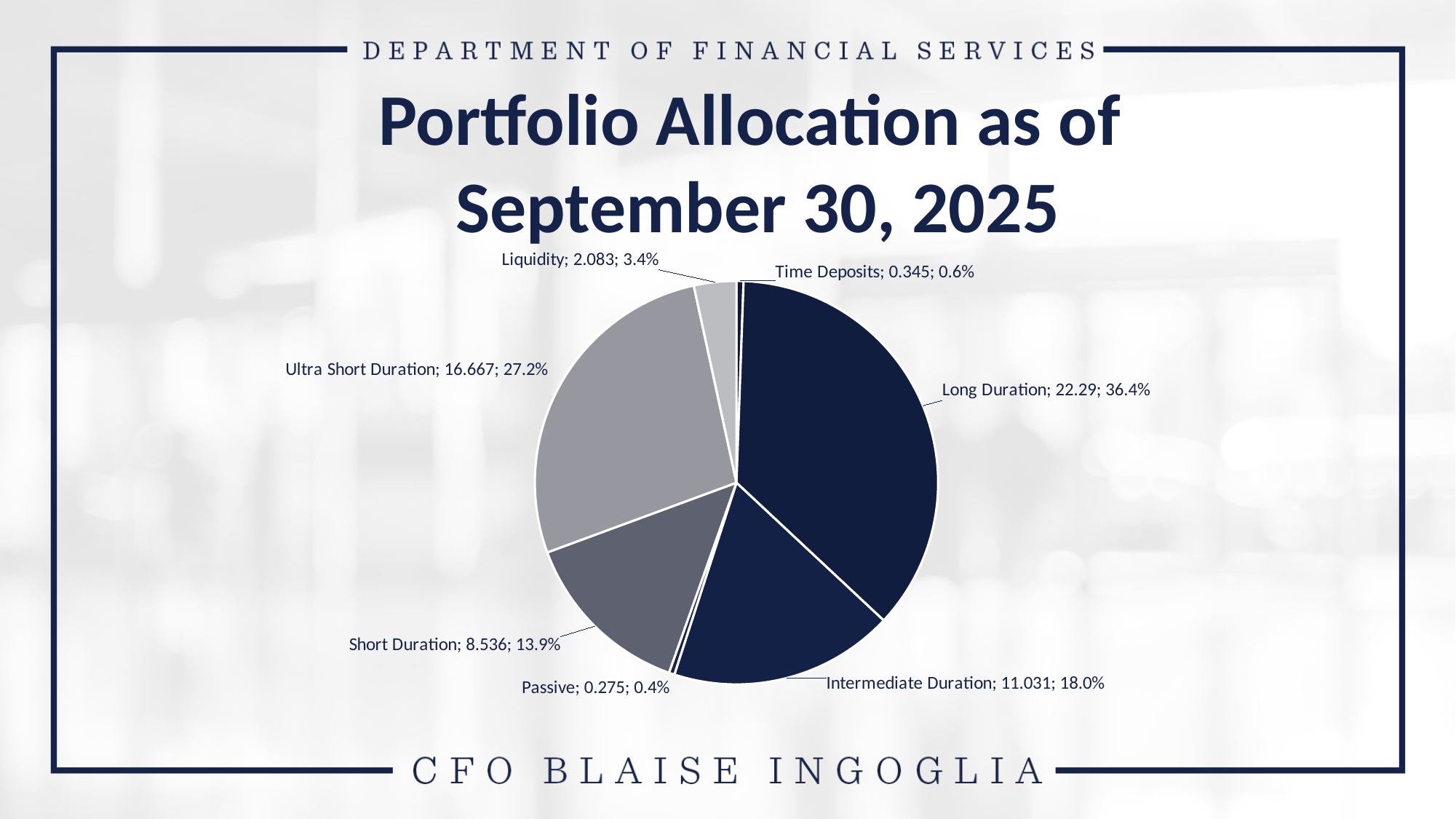
How many slices does the pie chart have? 7 What share of the pie does Ultra Short Duration represent? 27.2% Which category has the smallest slice of the pie? Passive What is the value shown for Time Deposits? 0.345 What is the value shown for Long Duration? 22.29 What is the difference between the values for Long Duration and Ultra Short Duration? 5.623 Which category has the largest slice of the pie? Long Duration What kind of chart is shown on the slide? Pie chart What is the title of the chart on the slide? Portfolio Allocation as of September 30, 2025 Which is larger, the value for Short Duration or the value for Liquidity? Short Duration What is the value shown for Intermediate Duration? 11.031 What share of the pie does Passive represent? 0.4%